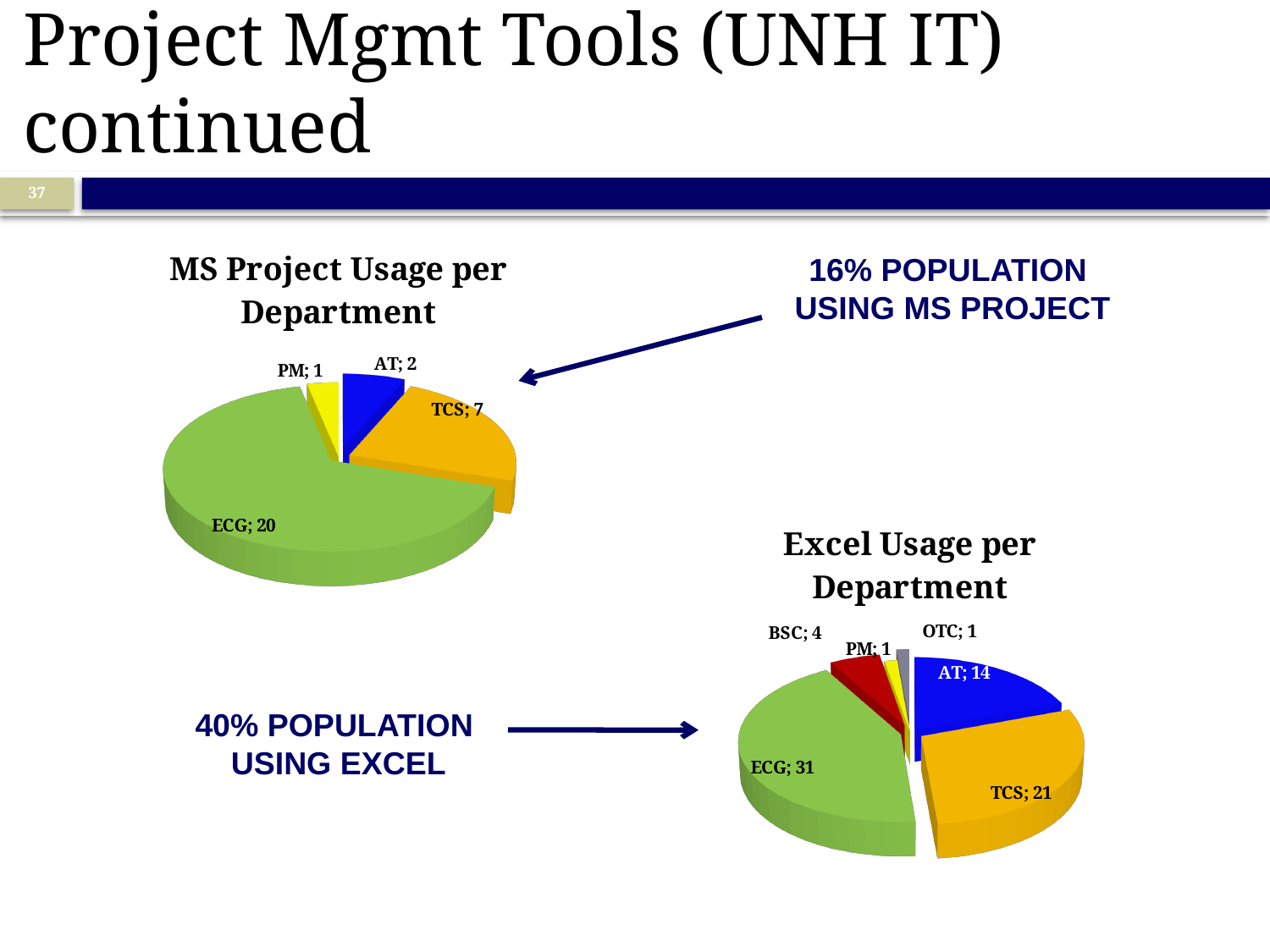
In the 'MS Project Usage per Department' chart, which department has the lowest value? PM In the 'MS Project Usage per Department' chart, what is the value for TCS? 7 What kind of chart is 'Excel Usage per Department'? Pie chart In the 'MS Project Usage per Department' chart, how many departments are shown? 4 In the 'Excel Usage per Department' chart, what is the difference between ECG and TCS? 10 In the 'MS Project Usage per Department' chart, what is the difference between ECG and TCS? 13 In the 'Excel Usage per Department' chart, what is the value for BSC? 4 In the 'Excel Usage per Department' chart, which department has the highest value? ECG In the 'Excel Usage per Department' chart, which is larger, TCS or AT? TCS In the 'Excel Usage per Department' chart, how many departments are shown? 6 In the 'MS Project Usage per Department' chart, what is the value for ECG? 20 In the 'Excel Usage per Department' chart, what is the value for AT? 14